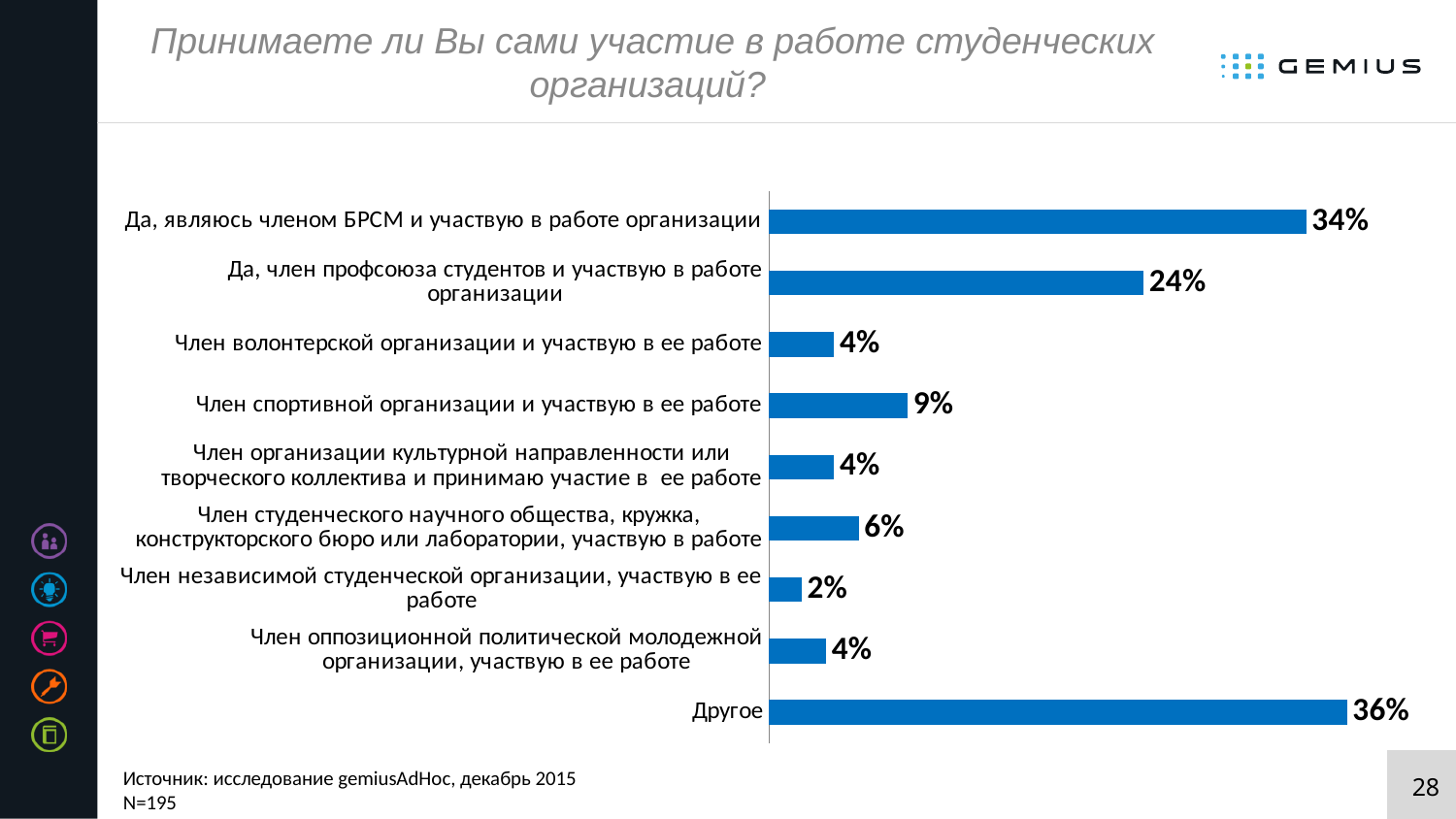
What is the value for "Да, член профсоюза студентов и участвую в работе организации"? 24% What is the sample size (N) stated on the slide? N=195 What kind of chart is shown on the slide? Bar chart Which category has the highest value? Другое What is the difference between "Да, являюсь членом БРСМ и участвую в работе организации" and "Да, член профсоюза студентов и участвую в работе организации"? 10% What is the value for "Другое"? 36% What is the value for "Да, являюсь членом БРСМ и участвую в работе организации"? 34% What is the value for "Член независимой студенческой организации, участвую в ее работе"? 2% Which category has the lowest value? Член независимой студенческой организации, участвую в ее работе How many categories are shown in the chart? 9 Which is larger: "Член спортивной организации и участвую в ее работе" or "Член студенческого научного общества, кружка, конструкторского бюро или лаборатории, участвую в работе"? Член спортивной организации и участвую в ее работе What is the value for "Член спортивной организации и участвую в ее работе"? 9%